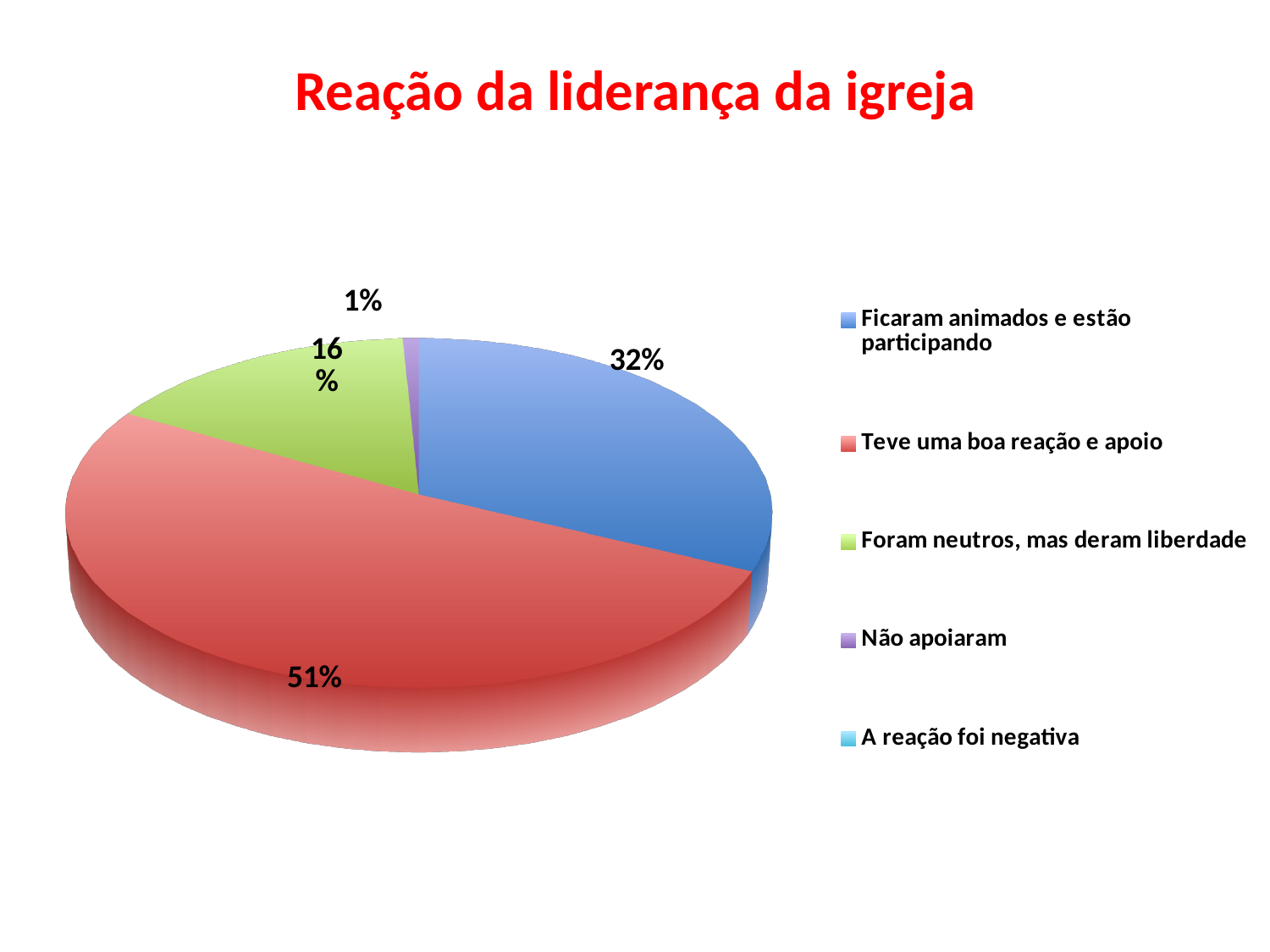
What percentage of the pie corresponds to "Não apoiaram"? 1% Which labelled slice has the smallest share of the pie? Não apoiaram What is the title of the chart? Reação da liderança da igreja Which is larger: the share for "Ficaram animados e estão participando" or the share for "Foram neutros, mas deram liberdade"? Ficaram animados e estão participando Which category has the largest share of the pie? Teve uma boa reação e apoio What percentage of the pie corresponds to "Foram neutros, mas deram liberdade"? 16% What is the difference in percentage points between "Teve uma boa reação e apoio" and "Ficaram animados e estão participando"? 19 What colour is the slice for "Foram neutros, mas deram liberdade"? green How many entries does the legend list? 5 What type of chart is shown on the slide? pie chart What percentage of the pie corresponds to "Teve uma boa reação e apoio"? 51% What percentage of the pie corresponds to "Ficaram animados e estão participando"? 32%